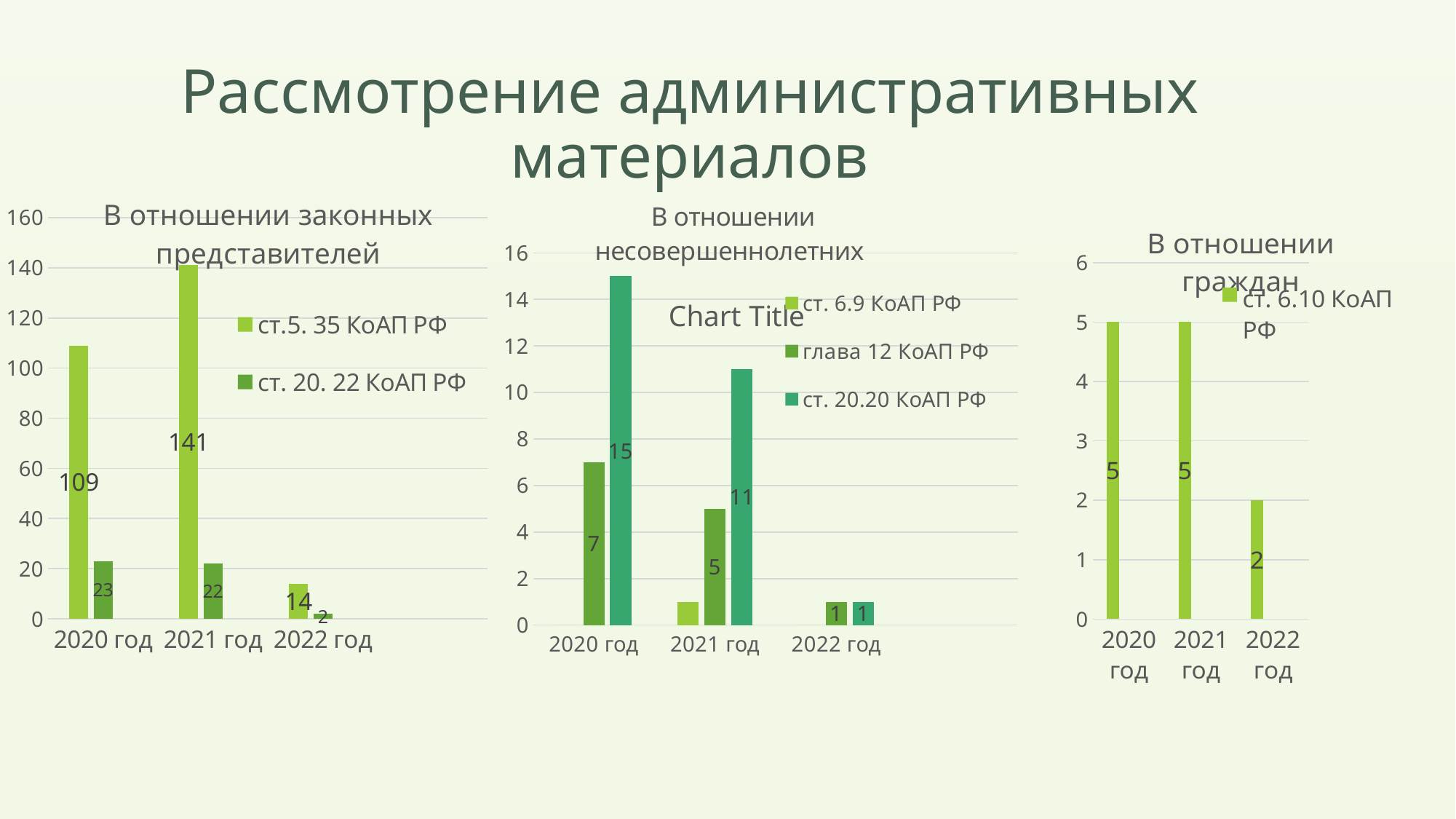
What type of chart is 'В отношении граждан'? Bar chart In the chart 'В отношении несовершеннолетних', what is the value for глава 12 КоАП РФ in 2021 год? 5 In the chart 'В отношении несовершеннолетних', what is the value for ст. 20.20 КоАП РФ in 2020 год? 15 In the chart 'В отношении несовершеннолетних', how many series does the legend list? 3 In the chart 'В отношении законных представителей', which year has the highest value for ст.5. 35 КоАП РФ? 2021 год In the chart 'В отношении законных представителей', what is the value for ст. 20. 22 КоАП РФ in 2020 год? 23 In the chart 'В отношении граждан', what is the value for 2022 год? 2 In the chart 'В отношении законных представителей', how many series does the legend list? 2 In the chart 'В отношении граждан', how many years are shown on the x axis? 3 In the chart 'В отношении несовершеннолетних', which is larger in 2021 год: глава 12 КоАП РФ or ст. 20.20 КоАП РФ? ст. 20.20 КоАП РФ In the chart 'В отношении законных представителей', what is the difference between the ст.5. 35 КоАП РФ values for 2021 год and 2020 год? 32 In the chart 'В отношении законных представителей', what is the value for ст.5. 35 КоАП РФ in 2021 год? 141